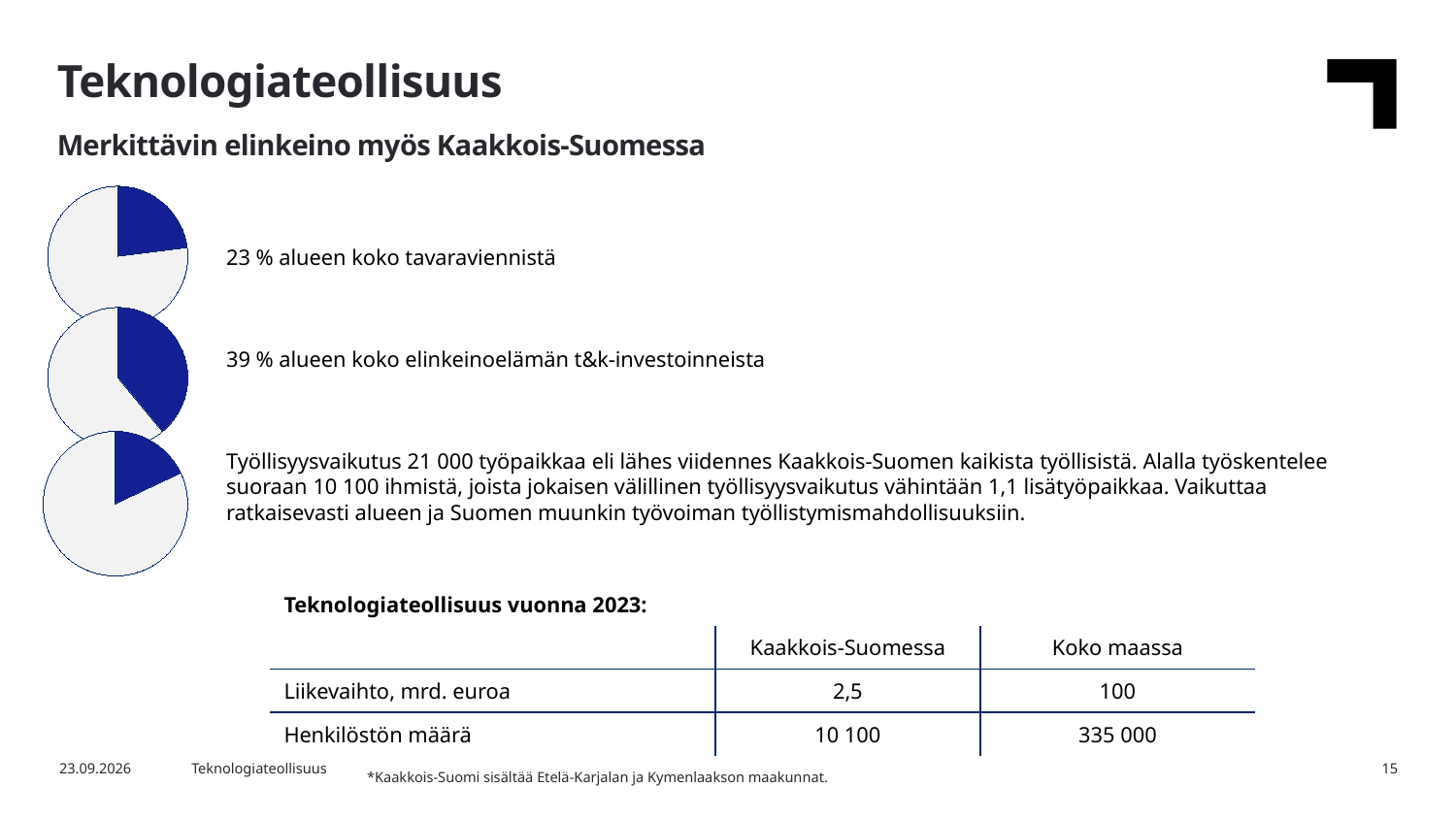
How many pie charts are shown on the slide? 3 Of the three pie charts, which one has the largest highlighted share? The middle one (t&k-investoinnit, 39 %) What kind of chart is the top chart on the left side of the slide? Pie chart Which pie chart has the larger highlighted slice, the top one (tavaravienti) or the middle one (t&k-investoinnit)? The middle one (t&k-investoinnit) What colour is the highlighted slice in the pie charts? Dark blue In the top pie chart, what share of the region's total goods exports (tavaravienti) does the highlighted slice represent? 23 % How many slices does each pie chart on the slide have? 2 In the middle pie chart, what share of the region's business R&D investments (t&k-investoinnit) does the highlighted slice represent? 39 % Which pie chart has the larger highlighted slice, the middle one (t&k-investoinnit) or the bottom one (työllisyysvaikutus)? The middle one (t&k-investoinnit) What does the top pie chart illustrate according to the text next to it? 23 % alueen koko tavaraviennistä